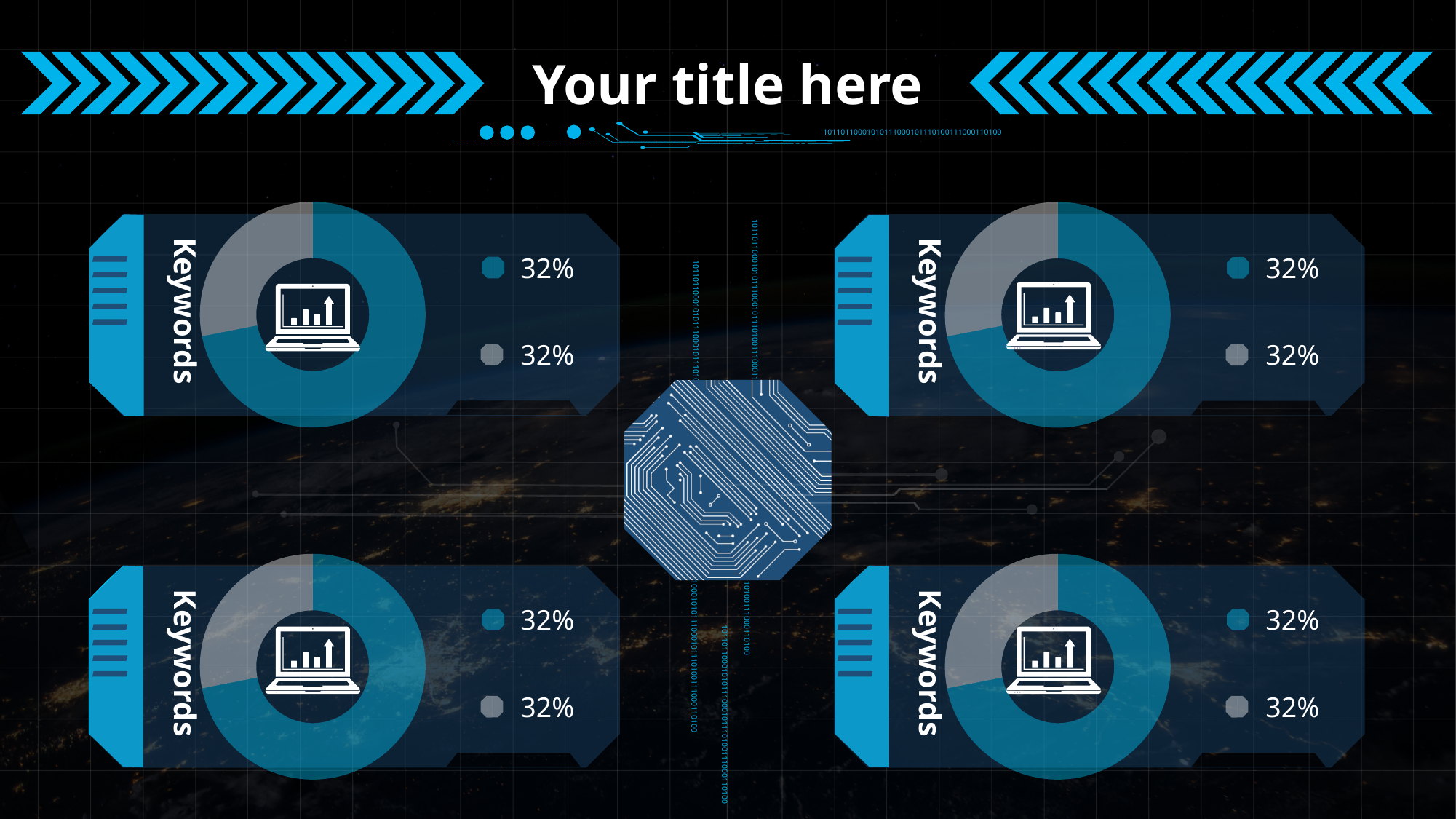
What is the title of the slide containing the four donut charts? Your title here How many slices does the bottom-right donut chart have? 2 In the top-left panel, what value is printed next to the gray legend marker? 32% How many slices does the top-left donut chart have? 2 How many donut charts are on the slide? 4 What kind of chart is shown in the top-left panel? donut chart How many entries does the legend next to the top-right donut chart list? 2 In the top-left panel, what value is printed next to the blue legend marker? 32% In the bottom-left panel, what value is printed next to the gray legend marker? 32% What label is written vertically beside each donut chart? Keywords In the bottom-right panel, what value is printed next to the blue legend marker? 32%